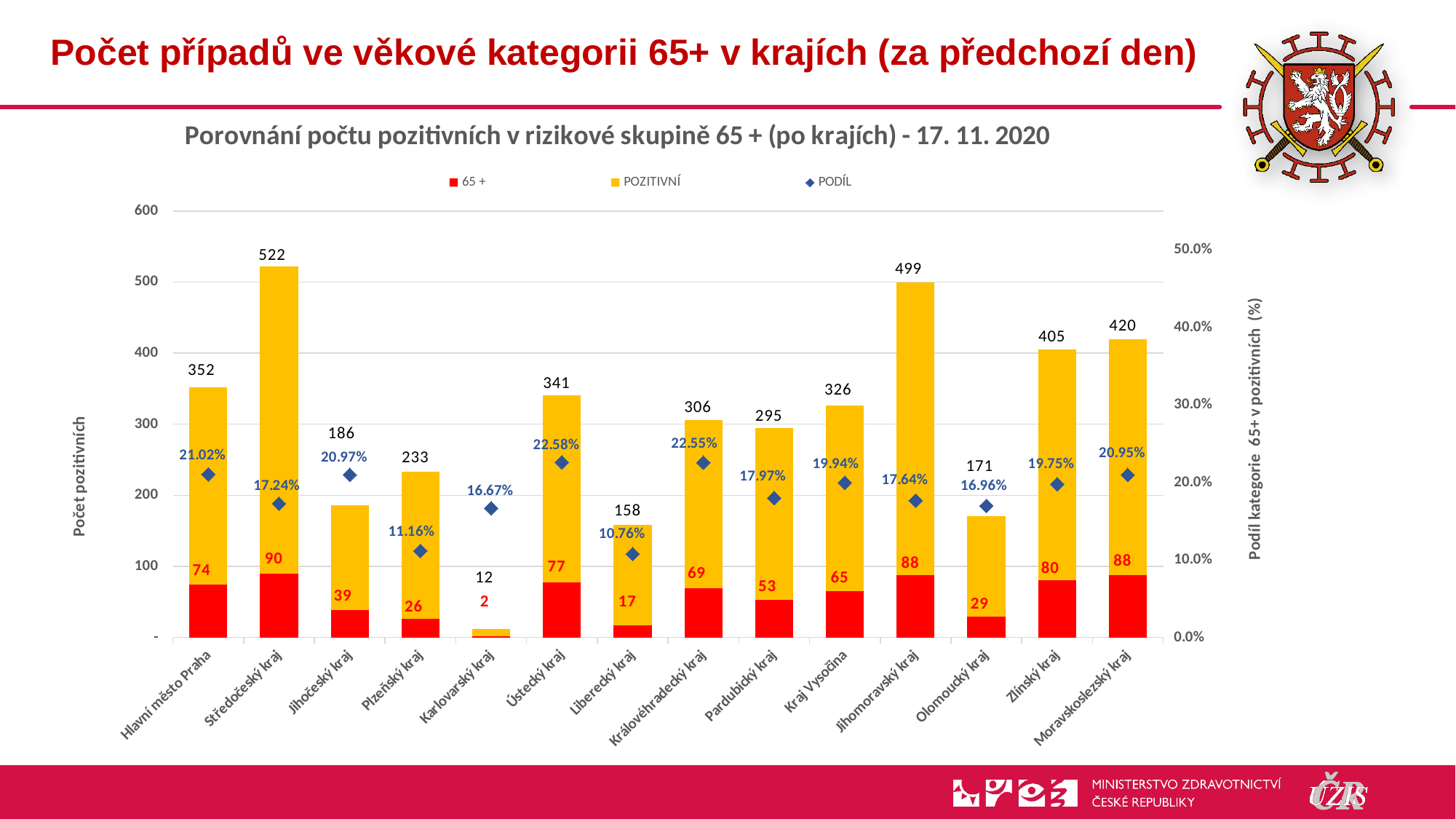
What kind of chart is this? Bar chart with a line/marker series (combo chart) How many series does the legend list? 3 What is the POZITIVNÍ value for Středočeský kraj? 522 Which region has the highest POZITIVNÍ value? Středočeský kraj Which region has the lowest PODÍL value? Liberecký kraj How many regions are shown on the x axis? 14 What is the difference between the POZITIVNÍ values for Jihomoravský kraj and Zlínský kraj? 94 What is the 65 + value for Jihomoravský kraj? 88 What is the title of the chart? Porovnání počtu pozitivních v rizikové skupině 65 + (po krajích) - 17. 11. 2020 Which is larger, the 65 + value for Hlavní město Praha or for Ústecký kraj? Ústecký kraj What is the PODÍL value for Ústecký kraj? 22.58% Is the POZITIVNÍ value for Moravskoslezský kraj greater or less than 400? greater